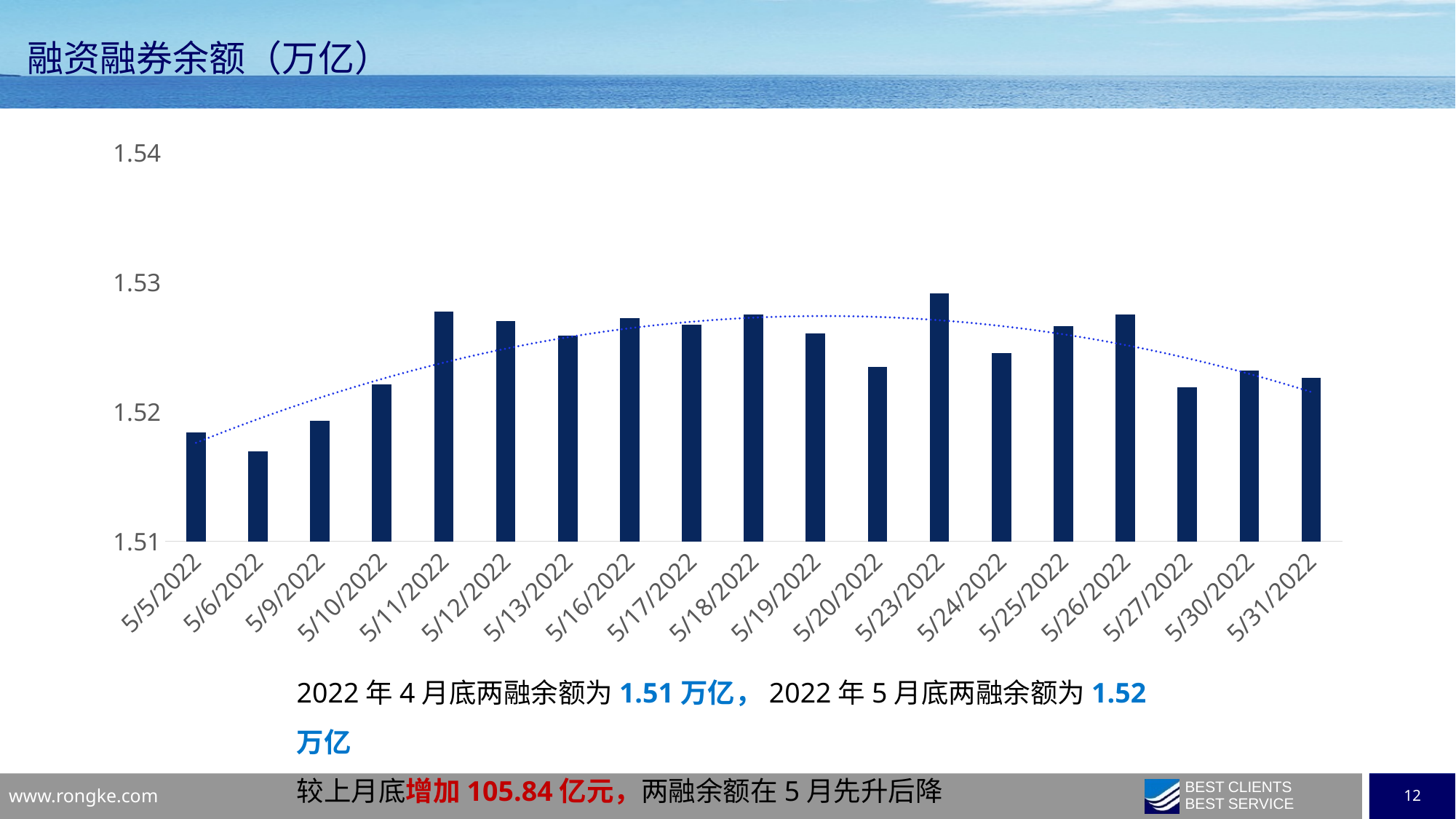
What kind of chart is shown on the slide? bar chart Is the value for 5/6/2022 greater or less than 1.52? less Is the value for 5/18/2022 greater or less than 1.52? greater Is the value for 5/23/2022 greater or less than 1.53? less Which is larger, the value for 5/10/2022 or the value for 5/9/2022? 5/10/2022 Which date has the highest bar in the chart? 5/23/2022 Which date has the lowest bar in the chart? 5/6/2022 Which is larger, the value for 5/23/2022 or the value for 5/24/2022? 5/23/2022 How many dates are plotted on the x axis of the chart? 19 What is the title of the chart on the slide? 融资融券余额（万亿） How do the values change from 5/5/2022 to 5/31/2022 along the x axis? rise first, then fall